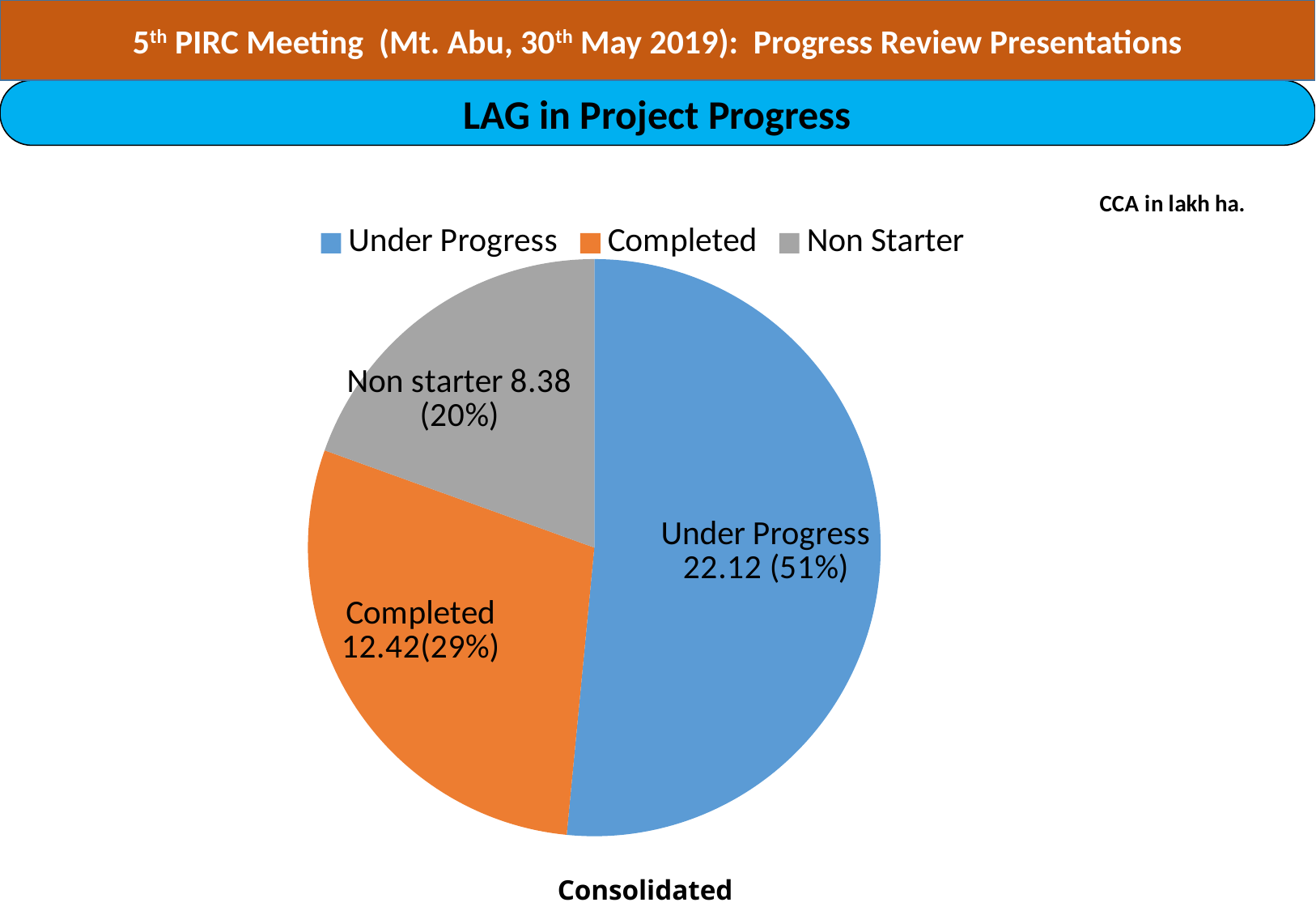
What kind of chart is shown on the slide? Pie chart What is the difference between the Under Progress value and the Completed value? 9.70 What unit is stated for the chart values? lakh ha. What is the value for Under Progress? 22.12 What share of the pie does Under Progress represent? 51% How many categories does the legend list? 3 What is the value for Completed? 12.42 Which is larger, the value for Completed or the value for Non starter? Completed Which category has the largest slice of the pie? Under Progress What share of the pie does Completed represent? 29% What is the value for Non starter? 8.38 Which category has the smallest slice of the pie? Non Starter